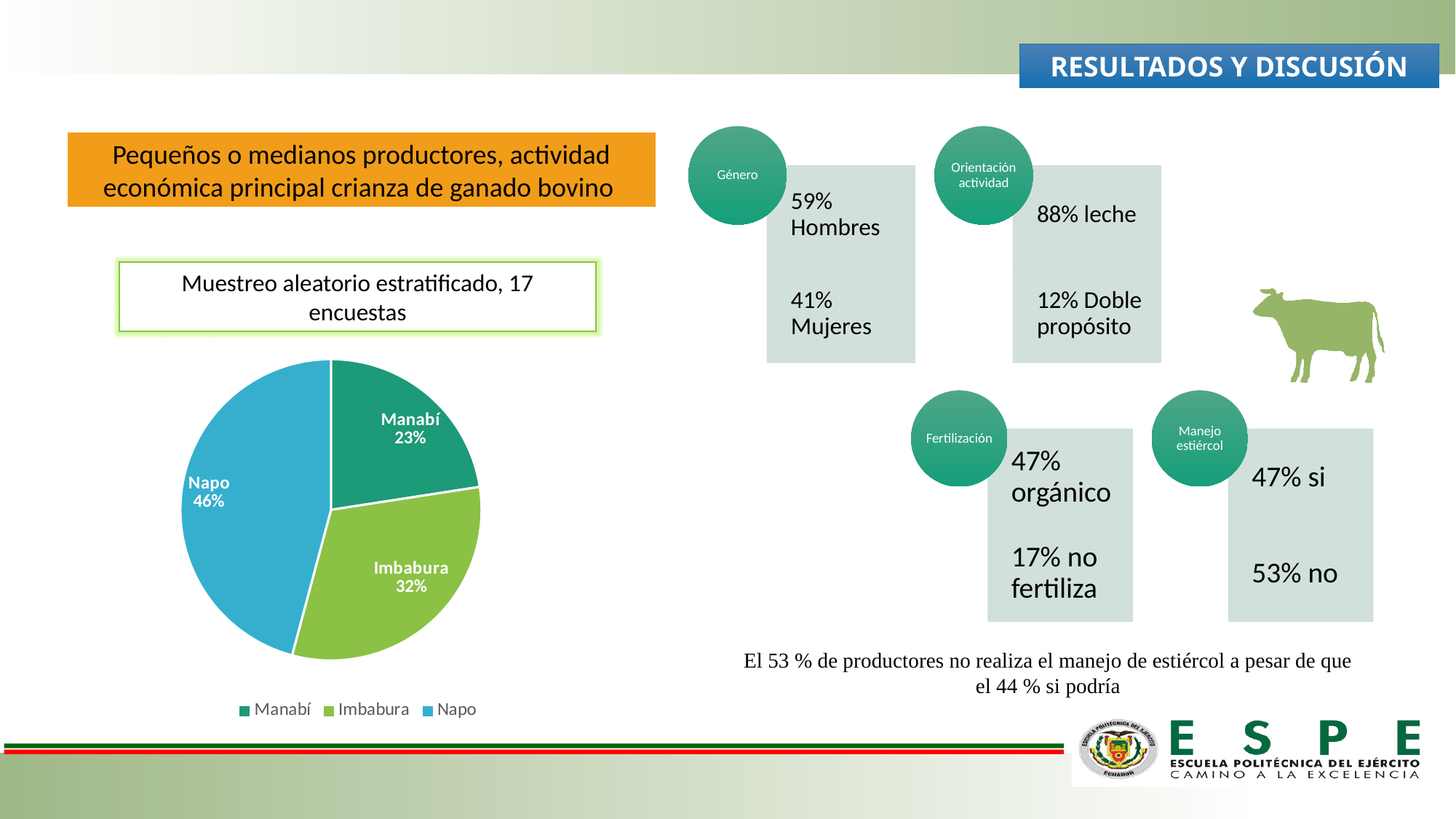
Which slice of the pie chart is the largest? Napo What kind of chart is shown on the slide? pie chart Which slice of the pie chart is the smallest? Manabí What is the difference in percentage points between the Napo and Manabí slices? 23 What share of the pie does Manabí represent? 23% Which slice is larger, Imbabura or Manabí? Imbabura What colour is the Napo slice in the pie chart? light blue How many entries does the pie chart's legend list? 3 What share of the pie does Imbabura represent? 32% How many slices does the pie chart have? 3 What is the difference in percentage points between the Imbabura and Manabí slices? 9 What share of the pie does Napo represent? 46%